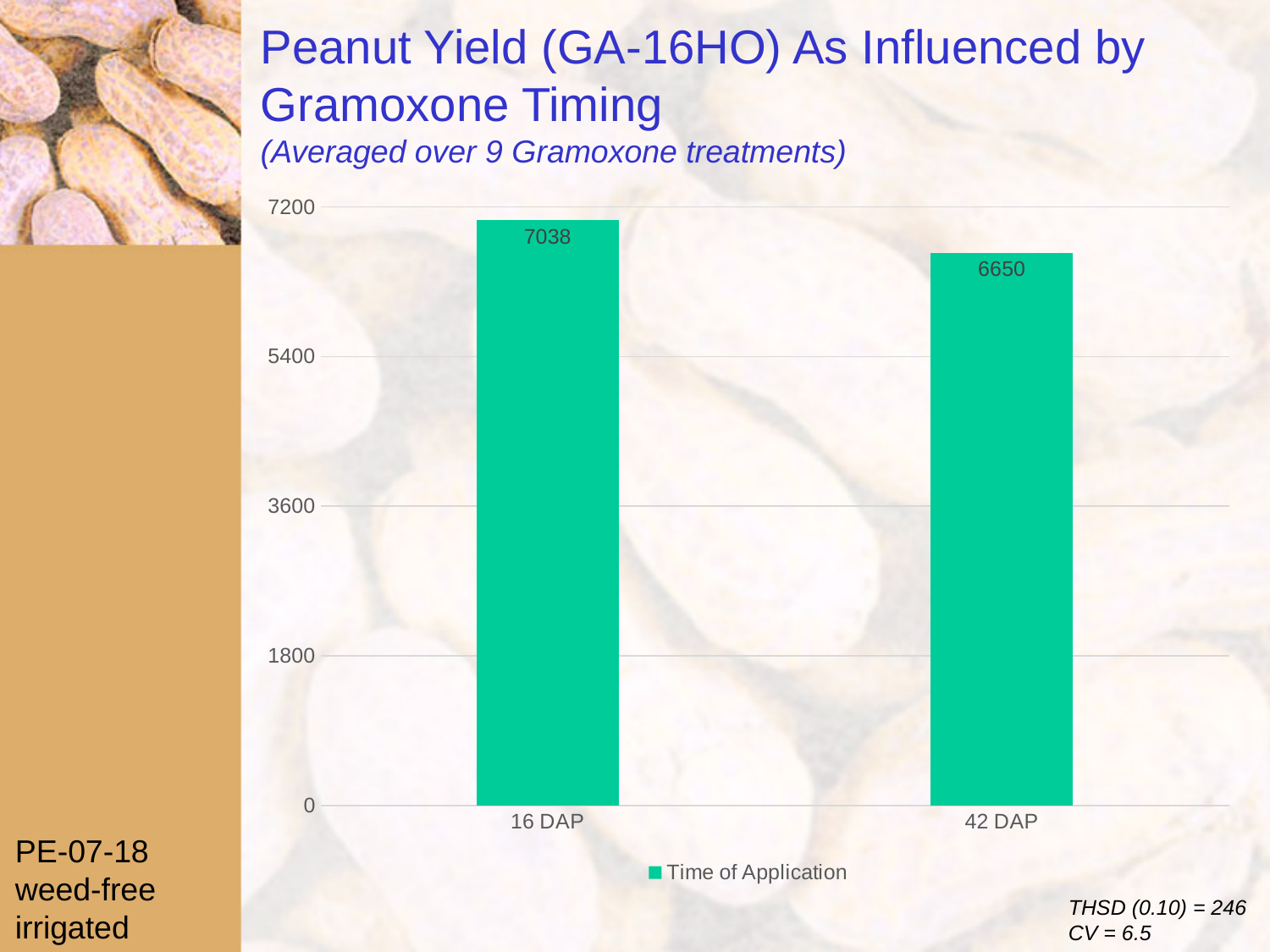
What is the legend entry for the series shown? Time of Application What is the peanut yield for 16 DAP? 7038 Is the value for 42 DAP greater or less than 5400? greater What kind of chart is shown on the slide? Bar chart Which application timing has the highest yield? 16 DAP What is the difference in yield between 16 DAP and 42 DAP? 388 How many application timings are shown on the chart? 2 Which application timing has the lowest yield? 42 DAP What is the peanut yield for 42 DAP? 6650 Is the value for 16 DAP greater or less than 7200? less How many series does the legend list? 1 Which has a larger yield, 16 DAP or 42 DAP? 16 DAP